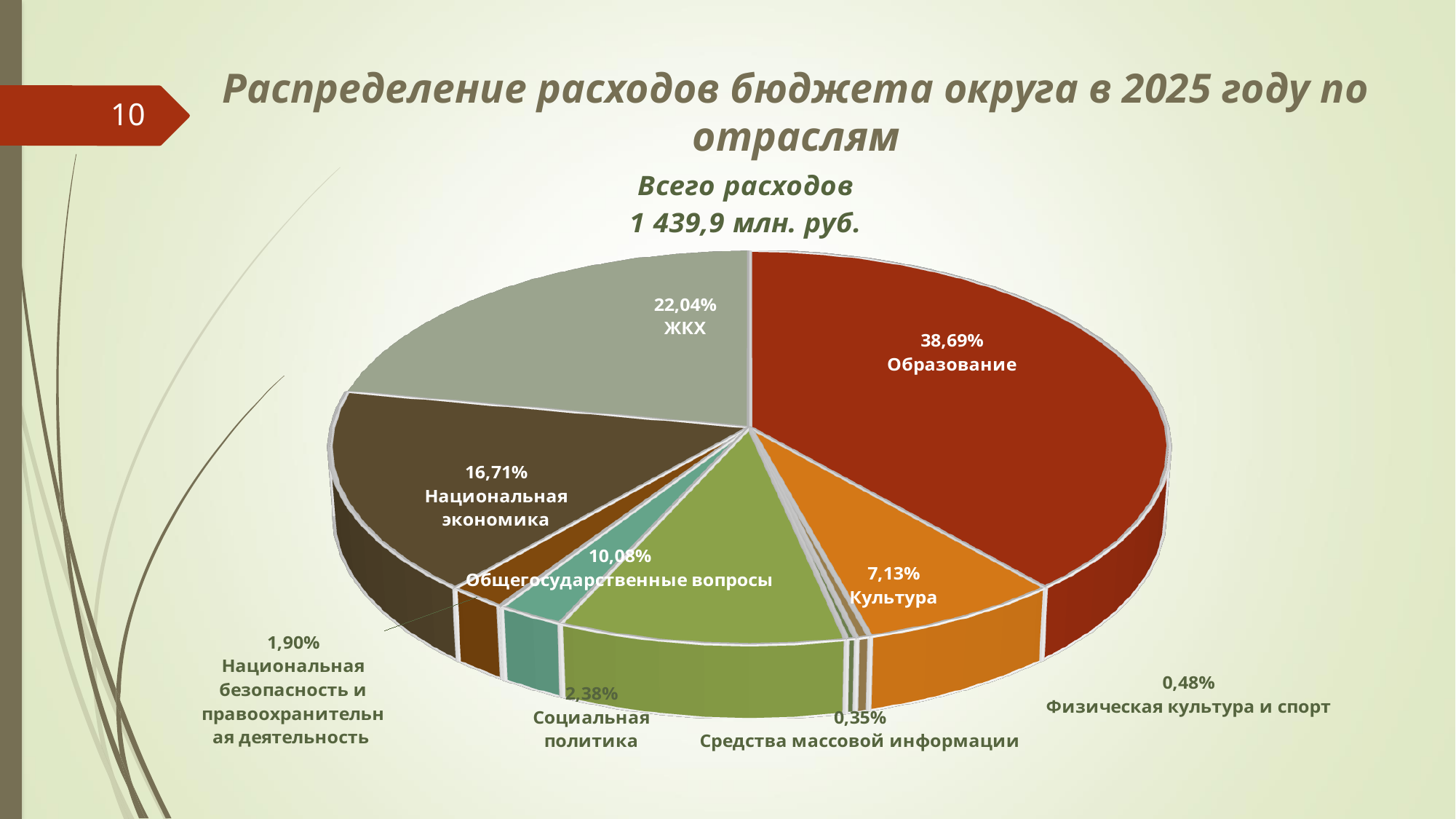
What type of chart is shown on the slide? Pie chart What is the difference in percentage points between Образование and ЖКХ? 16,65 What share is labelled for Национальная экономика? 16,71% How many sectors are shown in the pie chart? 10 Which has a larger share: Общегосударственные вопросы or Культура? Общегосударственные вопросы What share of the budget expenditure goes to Образование? 38,69% What percentage is shown for Культура? 7,13% What percentage is shown for ЖКХ? 22,04% What share is shown for Средства массовой информации? 0,35% What total expenditure amount is stated above the chart? 1 439,9 млн. руб. Which sector has the largest share of expenditure? Образование